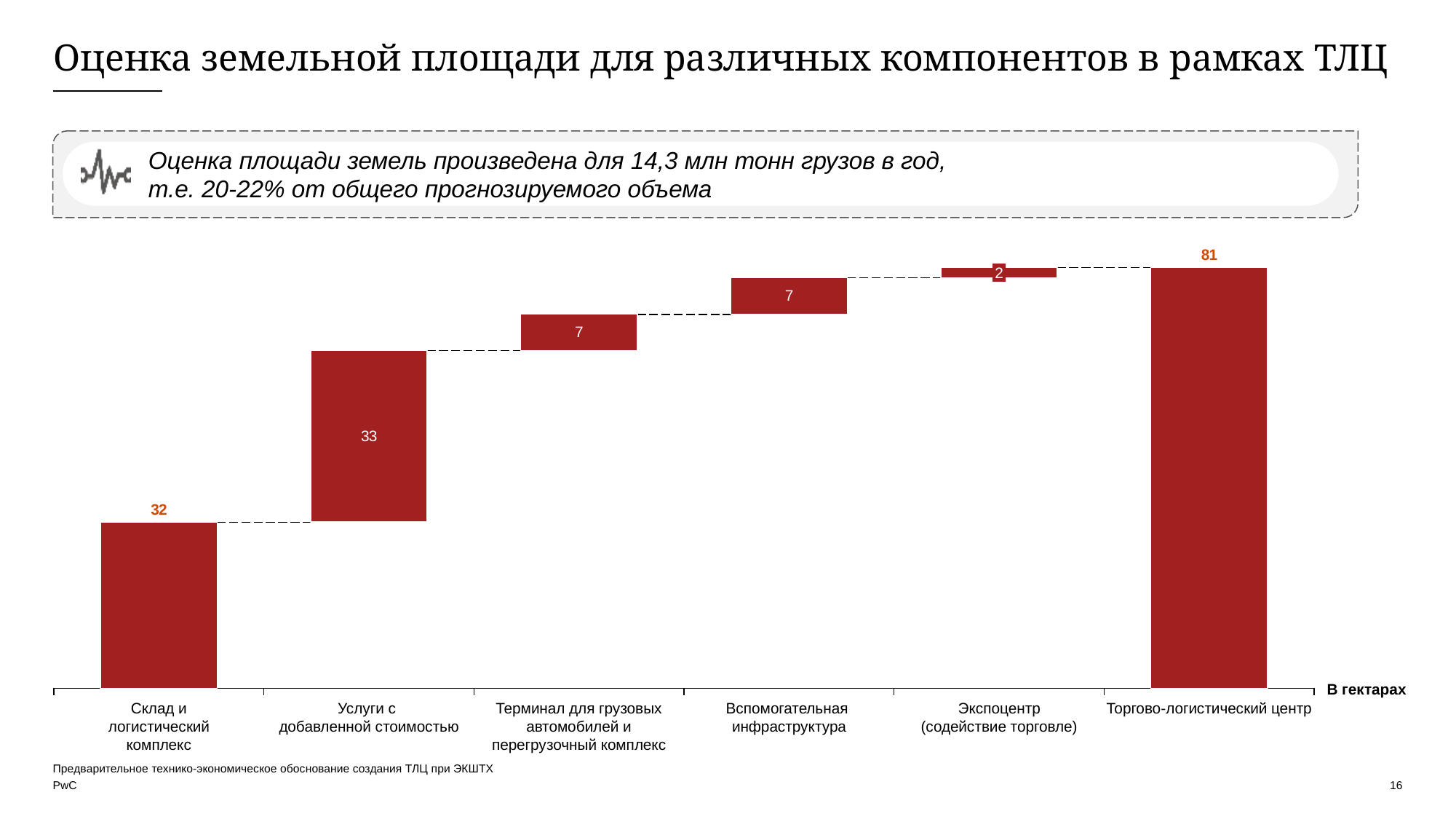
Which component has the smallest value? Экспоцентр (содействие торговле) Which bar has the highest value on the chart? Торгово-логистический центр What is the value for Склад и логистический комплекс? 32 How many categories are shown on the x axis? 6 In what units are the values on the chart expressed? В гектарах What is the difference between the values for Услуги с добавленной стоимостью and Склад и логистический комплекс? 1 What is the value for Вспомогательная инфраструктура? 7 What is the value shown for Торгово-логистический центр? 81 What is the value for Услуги с добавленной стоимостью? 33 What type of chart is shown on the slide? Bar chart (waterfall) What is the value for Экспоцентр (содействие торговле)? 2 Which is larger: the value for Склад и логистический комплекс or the value for Терминал для грузовых автомобилей и перегрузочный комплекс? Склад и логистический комплекс